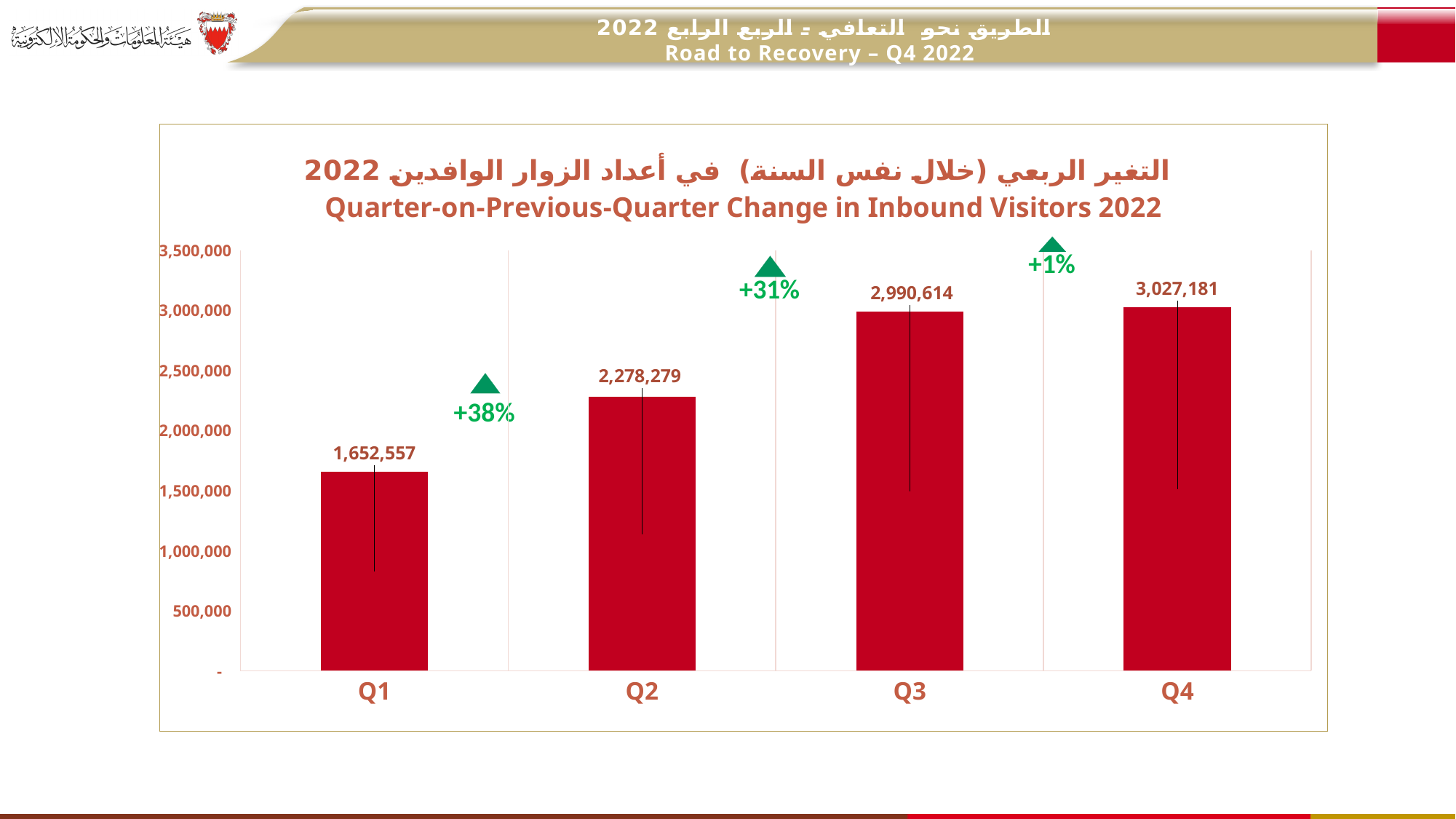
Is the value for Q2 greater or less than 2,000,000? greater What kind of chart is shown on the slide? bar chart Which is larger, the value for Q2 or the value for Q3? Q3 What percentage change is shown between Q2 and Q3? +31% Which quarter has the lowest number of inbound visitors? Q1 What is the value for Q1 in the Quarter-on-Previous-Quarter Change in Inbound Visitors 2022 chart? 1,652,557 What is the value for Q4 in the chart? 3,027,181 What is the difference between the Q4 and Q3 values? 36,567 Which quarter has the highest number of inbound visitors? Q4 How many quarters are shown in the chart? 4 What is the difference between the Q2 and Q1 values? 625,722 What is the value for Q3 in the chart? 2,990,614